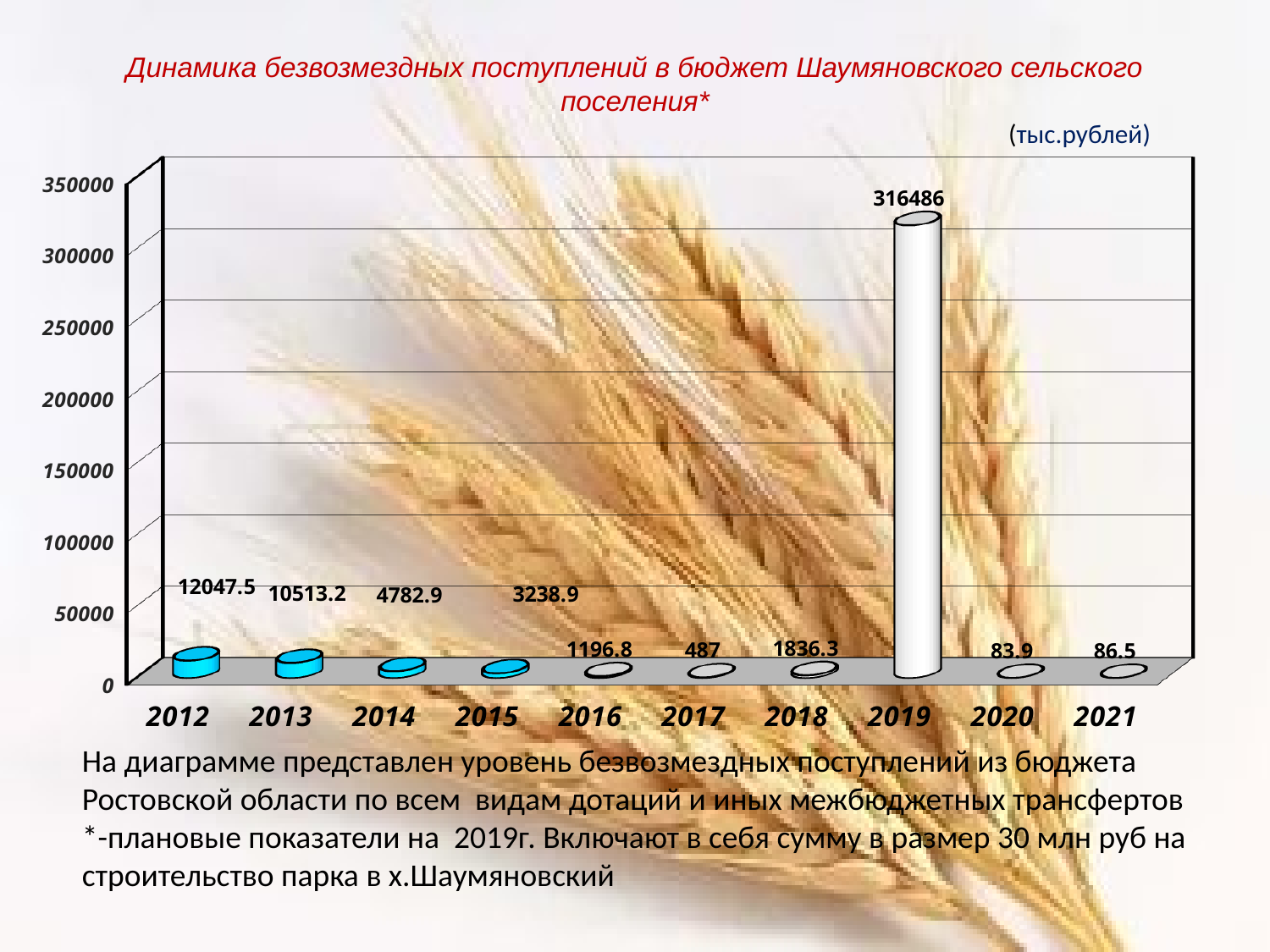
Значение за 2019 год больше или меньше 300000? больше Какое значение показано для 2017 года? 487 Какое значение больше: за 2014 год или за 2015 год? 2014 Как изменяются значения с 2012 по 2016 год — растут или падают? падают В каком году безвозмездные поступления были наименьшими? 2020 Какое значение показано для 2019 года? 316486 На сколько значение 2012 года больше значения 2013 года? 1534.3 Какое значение показано для 2012 года? 12047.5 Какое значение показано для 2021 года? 86.5 Сколько лет (категорий) показано на диаграмме? 10 В каком году безвозмездные поступления были наибольшими? 2019 На сколько значение 2018 года больше значения 2017 года? 1349.3